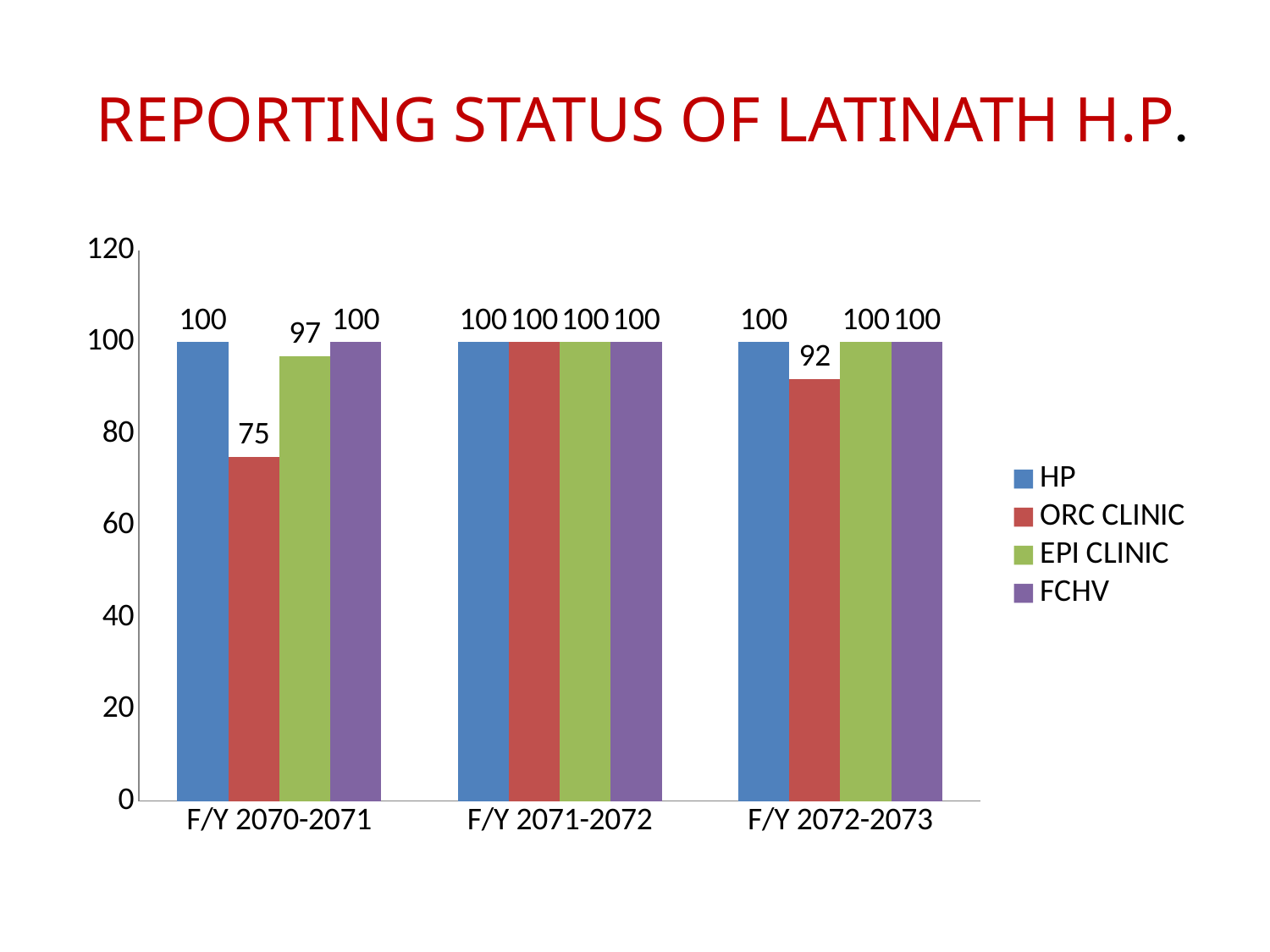
What is the value for HP in F/Y 2071-2072? 100 How many series does the legend list? 4 Which is larger in F/Y 2070-2071: the value for EPI CLINIC or the value for ORC CLINIC? EPI CLINIC What is the title of the chart? REPORTING STATUS OF LATINATH H.P. What is the difference between the ORC CLINIC values in F/Y 2072-2073 and F/Y 2070-2071? 17 What is the value for ORC CLINIC in F/Y 2070-2071? 75 Which series has the lowest value in F/Y 2072-2073? ORC CLINIC What kind of chart is shown on the slide? Bar chart What is the value for EPI CLINIC in F/Y 2070-2071? 97 How many fiscal year categories are shown on the x axis? 3 Which series has the lowest value in F/Y 2070-2071? ORC CLINIC What is the value for ORC CLINIC in F/Y 2072-2073? 92